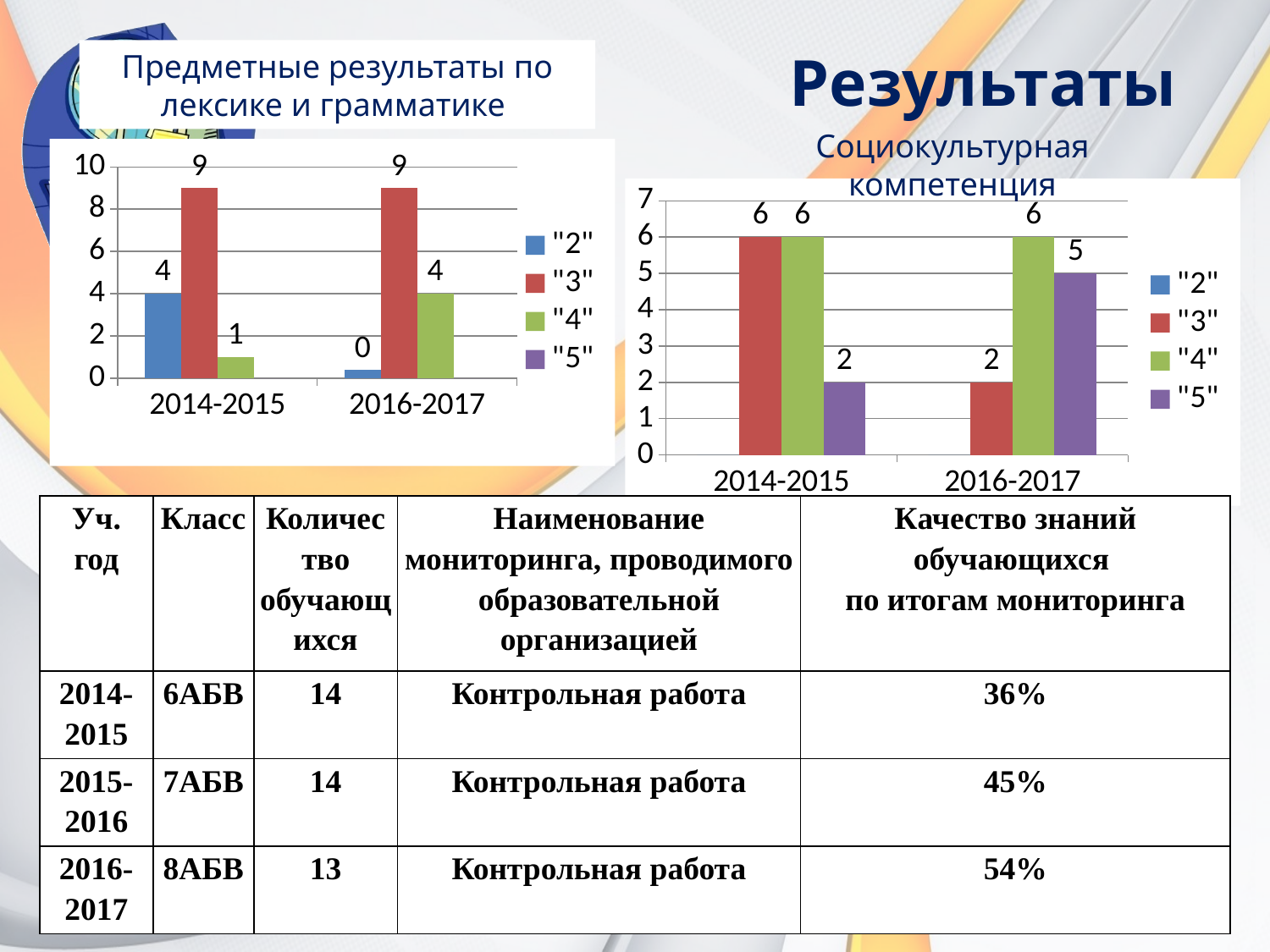
In the left chart (Предметные результаты по лексике и грамматике), what is the value for "3" in 2014-2015? 9 What type of chart is the right chart (Социокультурная компетенция)? Bar chart In the right chart (Социокультурная компетенция), what is the difference between the values for "4" and "3" in 2016-2017? 4 In the left chart (Предметные результаты по лексике и грамматике), what is the value for "2" in 2016-2017? 0 In the left chart (Предметные результаты по лексике и грамматике), what is the difference between the values for "2" and "4" in 2014-2015? 3 In the right chart (Социокультурная компетенция), what is the value for "5" in 2016-2017? 5 In the left chart (Предметные результаты по лексике и грамматике), which series has the highest value in 2014-2015? "3" In the left chart (Предметные результаты по лексике и грамматике), how many series does the legend list? 4 In the left chart (Предметные результаты по лексике и грамматике), what is the value for "4" in 2016-2017? 4 In the right chart (Социокультурная компетенция), is the value for "5" in 2014-2015 larger or smaller than the value for "5" in 2016-2017? smaller In the right chart (Социокультурная компетенция), what is the value for "3" in 2014-2015? 6